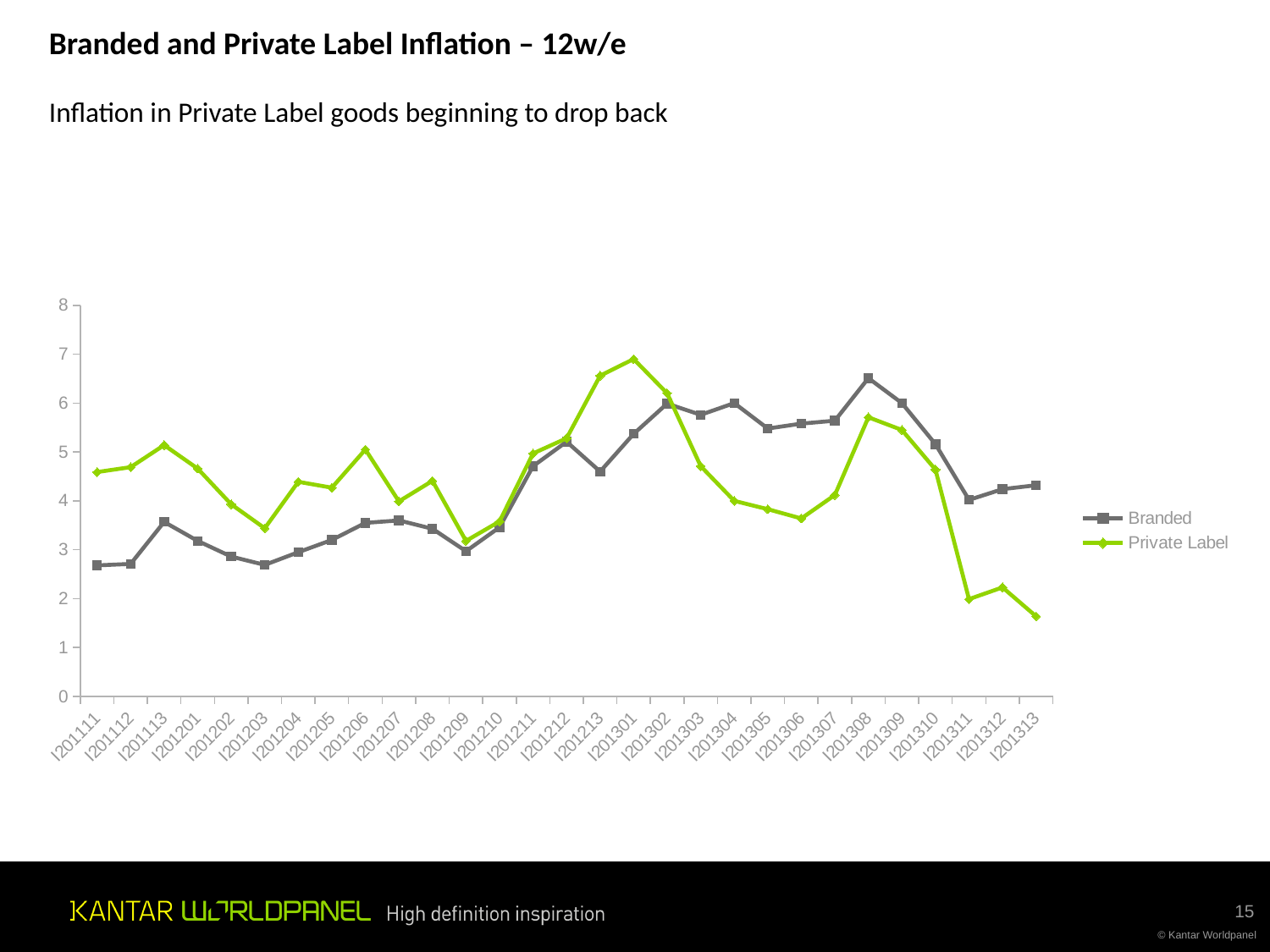
At which period does the Private Label series reach its highest value? I201301 Does the Private Label series rise or fall from l201308 to l201313? fall Is the Branded value at l201111 greater or less than 3? less At l201313, which series has the higher value, Branded or Private Label? Branded How many series does the legend list? 2 At which period does the Private Label series reach its lowest value? I201313 What kind of chart is shown on the slide? line chart Is the Private Label value at l201313 greater or less than 2? less At l201111, which series has the higher value, Branded or Private Label? Private Label At which period does the Branded series reach its highest value? I201308 How many time periods are plotted along the x axis? 29 Is the Branded value at l201308 greater or less than 6? greater